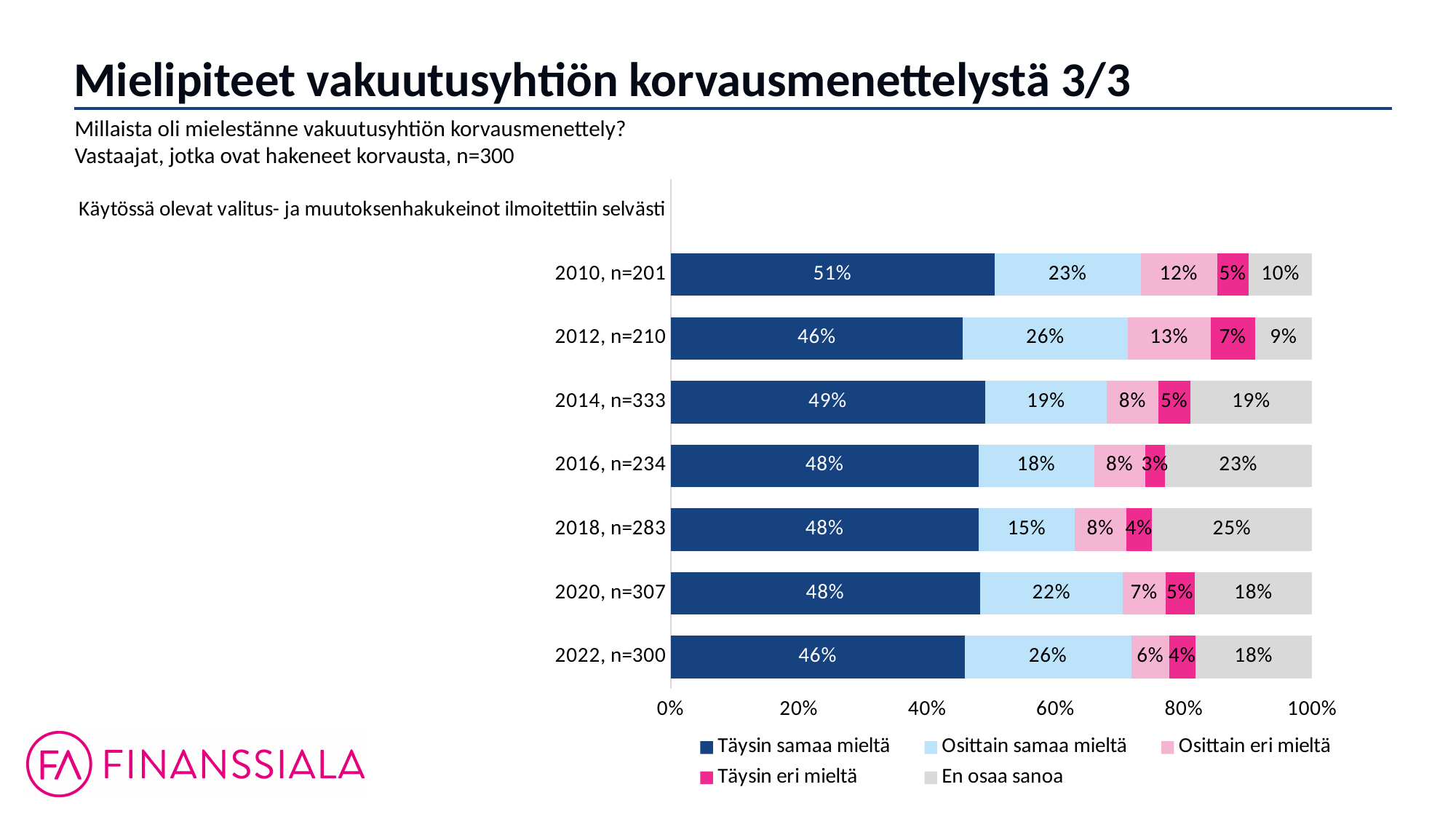
Which year has the highest value for 'Täysin samaa mieltä'? 2010, n=201 What is the value of 'Täysin eri mieltä' for 2012, n=210? 7% What kind of chart is shown on the slide? stacked bar chart What is the value of 'Osittain samaa mieltä' for 2022, n=300? 26% Which is larger: 'Osittain samaa mieltä' for 2012, n=210 or for 2018, n=283? 2012, n=210 What is the difference between the 'En osaa sanoa' values for 2018, n=283 and 2010, n=201? 15% How many year categories are plotted in the chart? 7 How many series does the legend list? 5 Which year has the lowest value for 'En osaa sanoa'? 2012, n=210 What is the value of 'Täysin samaa mieltä' for 2010, n=201? 51% What is the value of 'En osaa sanoa' for 2018, n=283? 25% What is the title of the chart? Käytössä olevat valitus- ja muutoksenhakukeinot ilmoitettiin selvästi